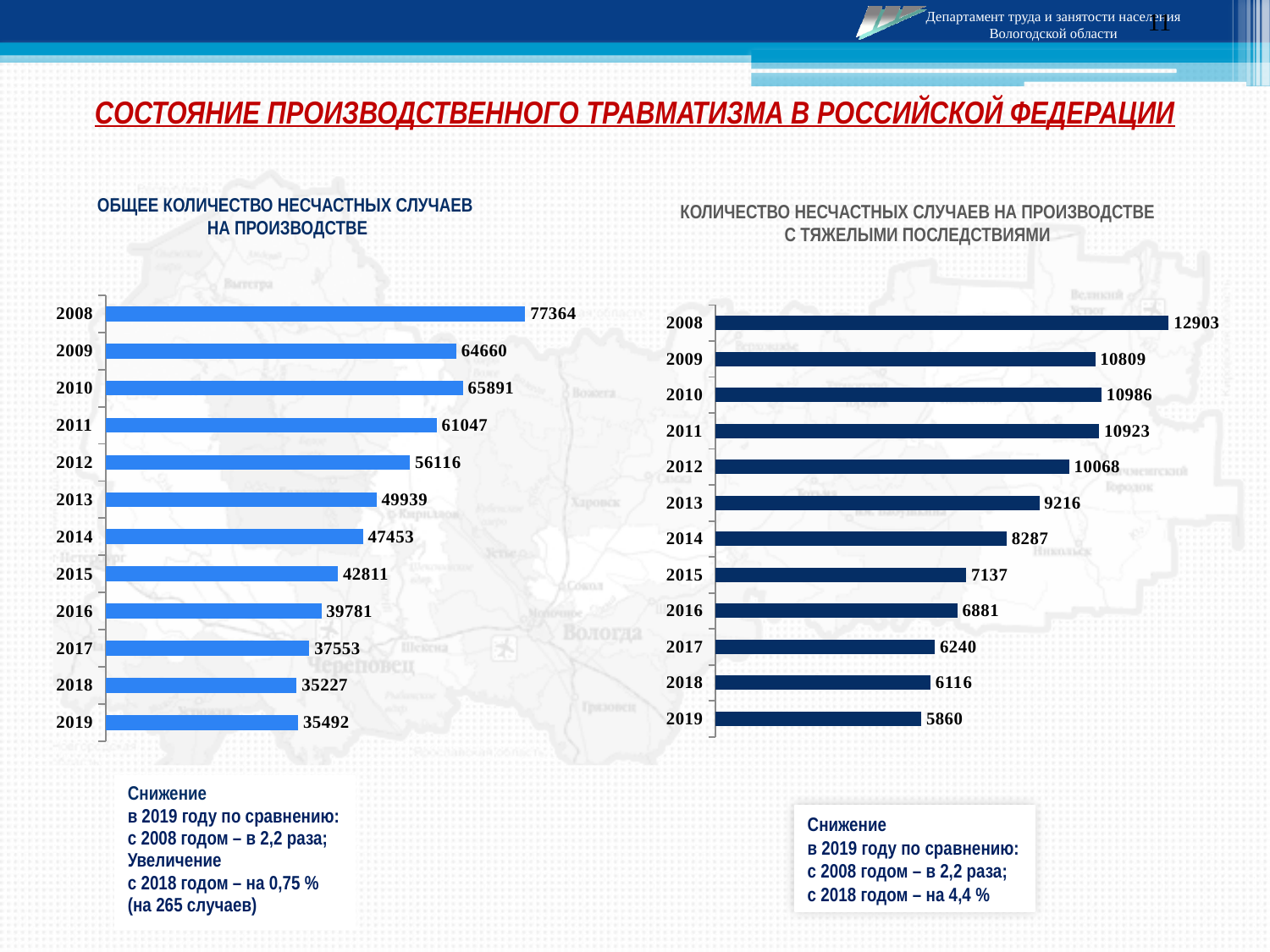
In the right chart (КОЛИЧЕСТВО НЕСЧАСТНЫХ СЛУЧАЕВ НА ПРОИЗВОДСТВЕ С ТЯЖЕЛЫМИ ПОСЛЕДСТВИЯМИ), what is the value for 2015? 7137 In the left chart, what is the difference between the values for 2008 and 2019? 41872 In the left chart, which year has the lowest value? 2018 In the left chart, which year has the highest value? 2008 How many years are shown in the right chart? 12 In the left chart (ОБЩЕЕ КОЛИЧЕСТВО НЕСЧАСТНЫХ СЛУЧАЕВ НА ПРОИЗВОДСТВЕ), what is the value for 2012? 56116 In the left chart, which year has the larger value, 2009 or 2010? 2010 In the right chart, which year has the larger value, 2013 or 2014? 2013 In the right chart, what is the difference between the values for 2018 and 2019? 256 In the right chart, do the values generally rise or fall from 2008 to 2019? Fall In the right chart, which year has the lowest value? 2019 What type of chart is the left chart? Bar chart